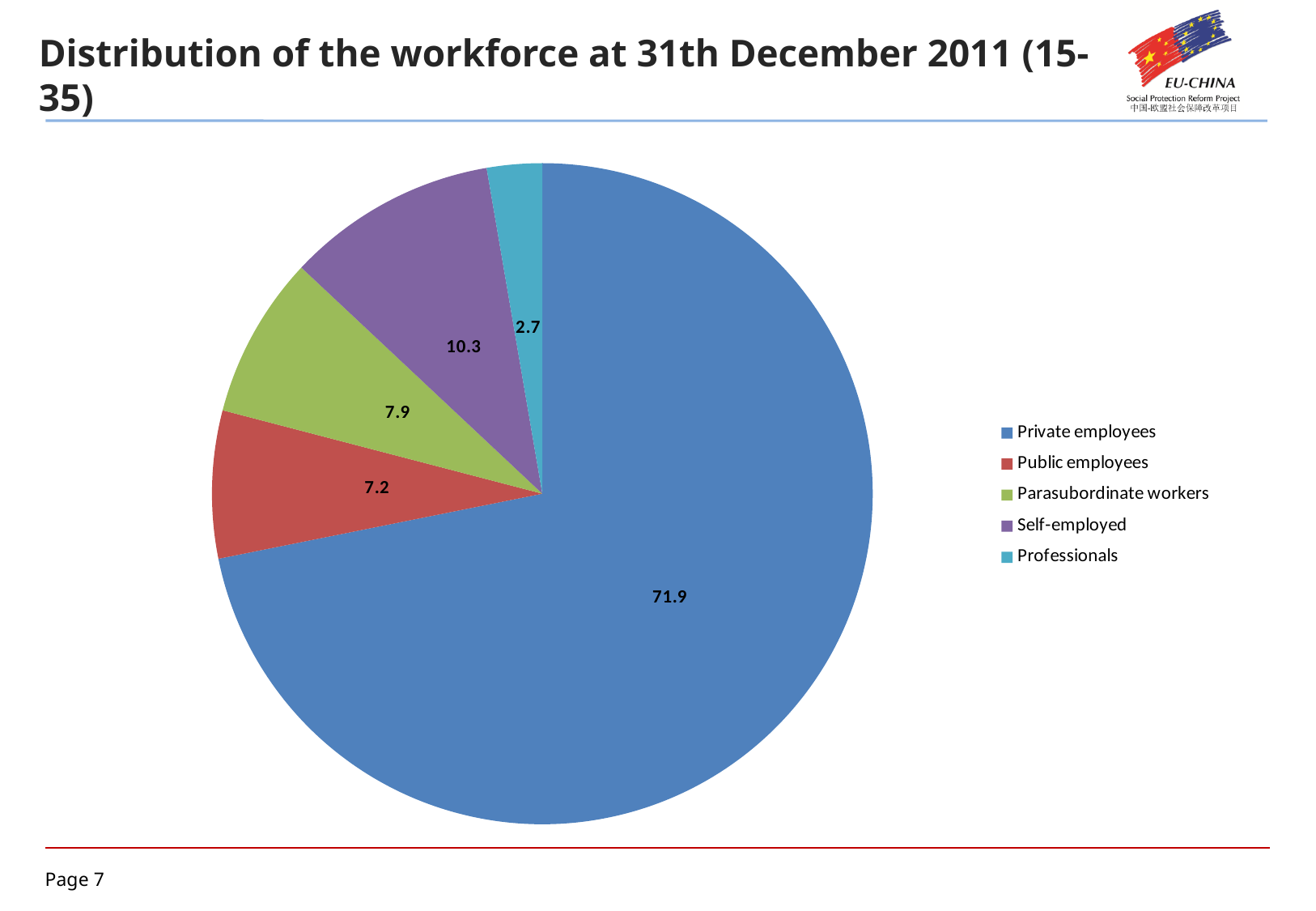
Which category has the smallest slice? Professionals What is the title of the slide? Distribution of the workforce at 31th December 2011 (15-35) Which category has the largest slice? Private employees What is the value for Professionals? 2.7 Which colour represents Self-employed in the legend? purple What kind of chart is shown on the slide? pie chart What is the value for Private employees? 71.9 What is the value for Self-employed? 10.3 Which is larger, the value for Parasubordinate workers or the value for Public employees? Parasubordinate workers What is the difference between the values for Self-employed and Public employees? 3.1 How many categories does the pie chart have? 5 What is the value for Parasubordinate workers? 7.9